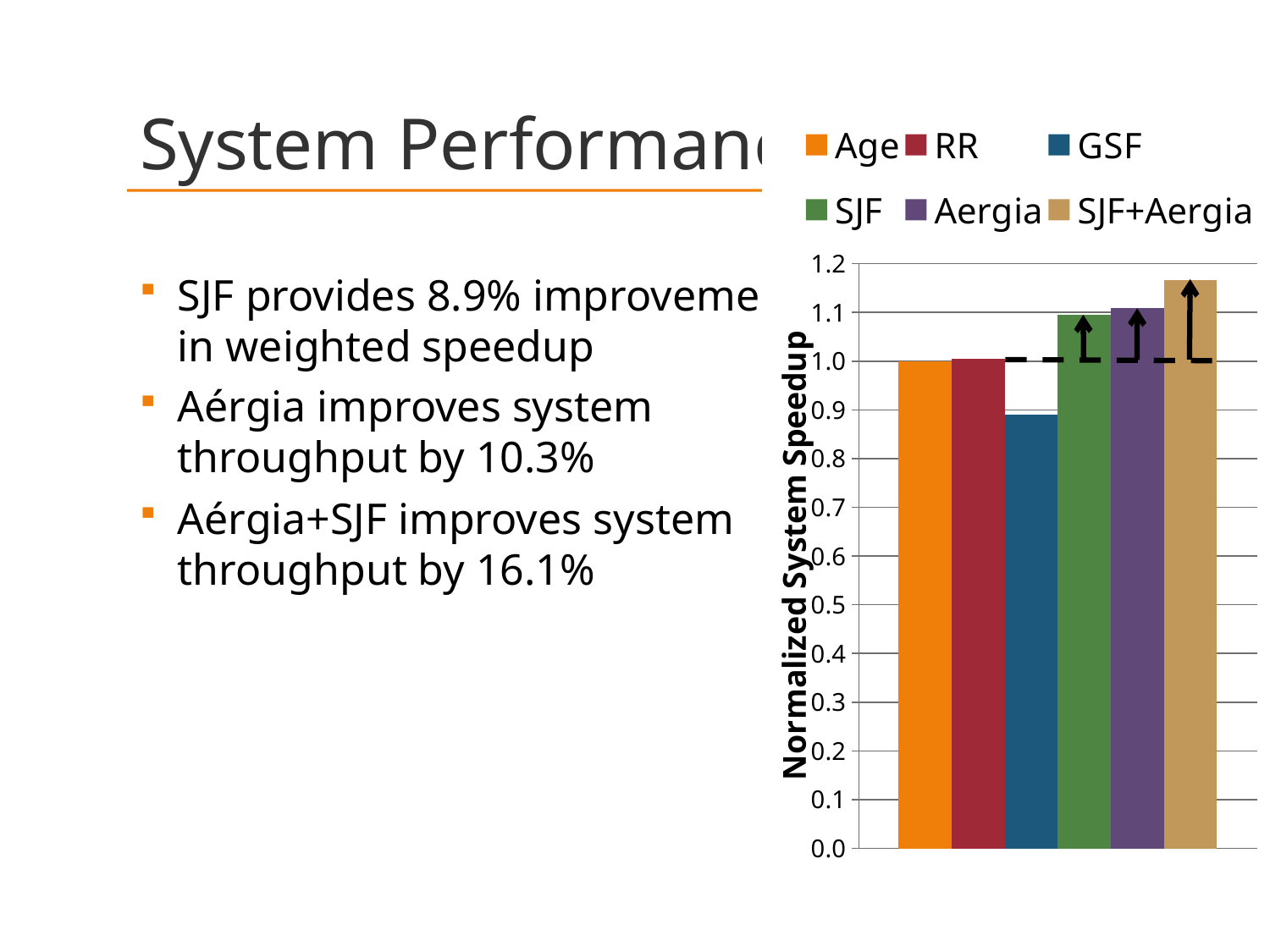
Which series has the lowest normalized system speedup? GSF How many series does the chart legend list? 6 Is the value for GSF greater or less than 1.0? less Is the value for SJF+Aergia greater or less than 1.1? greater Which is larger, the value for SJF+Aergia or the value for Age? SJF+Aergia What kind of chart is shown on the slide? bar chart Is the value for GSF greater or less than 0.8? greater Which is larger, the value for SJF or the value for GSF? SJF Which series has the highest normalized system speedup? SJF+Aergia What is the title of the chart's vertical axis? Normalized System Speedup What colour is the GSF bar in the chart? blue